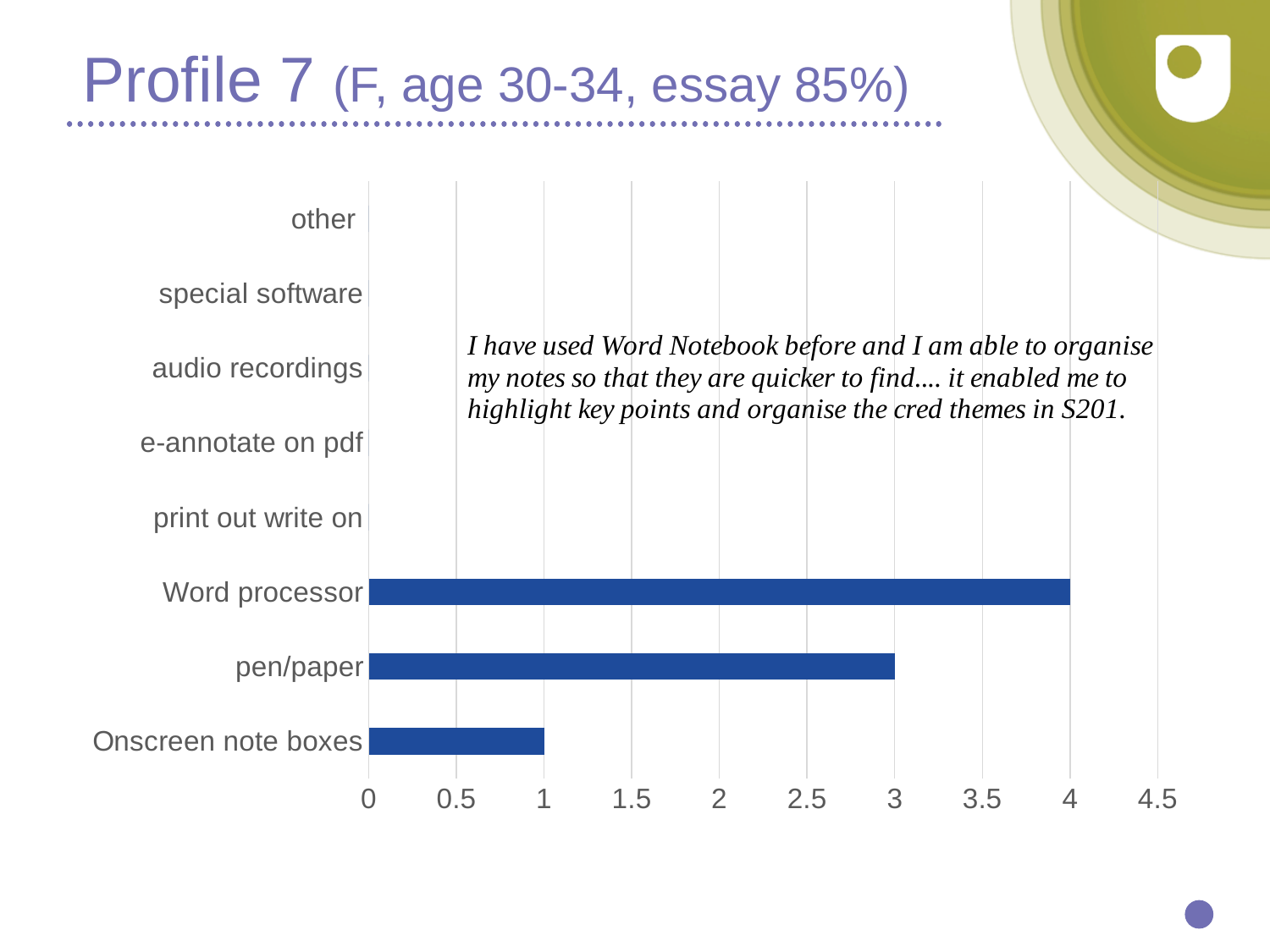
What is the highest value shown on the horizontal axis of the chart? 4.5 Which category has the highest value? Word processor What is the difference between the values for pen/paper and Onscreen note boxes? 2 Is the value for Word processor greater or less than 3.5? greater How many categories have a visible bar in the chart? 3 Which is larger, the value for pen/paper or the value for Onscreen note boxes? pen/paper What is the value for pen/paper? 3 What is the difference between the values for Word processor and pen/paper? 1 What is the value for Onscreen note boxes? 1 What kind of chart is shown on the slide? bar chart How many categories are listed on the vertical axis of the chart? 8 What is the value for Word processor? 4